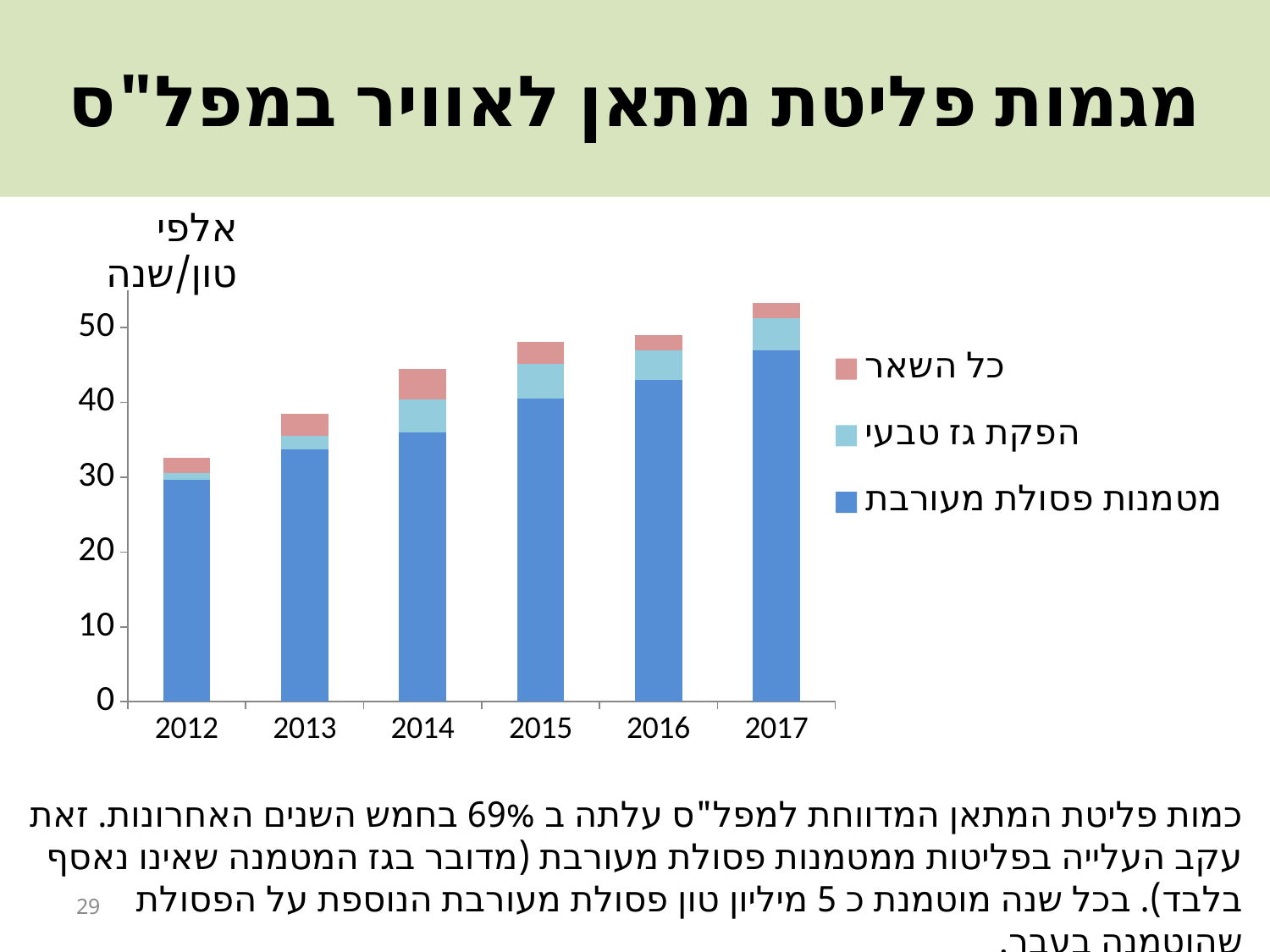
Is the value of the מטמנות פסולת מעורבת segment for 2017 greater or less than 40? greater What unit is written above the y axis of the chart? אלפי טון/שנה How many series does the chart's legend list? 3 Which year has the shortest stacked bar (lowest total methane emissions)? 2012 Do the total bar heights rise or fall from 2012 to 2017? Rise What kind of chart is shown on the slide? Stacked bar chart Is the total bar height for 2013 greater or less than 40? less Which legend entry is represented by the dark blue (bottom) segments of the bars? מטמנות פסולת מעורבת Is the total bar height for 2014 larger or smaller than the total for 2013? Larger Is the total bar height for 2017 greater or less than 50? greater How many years are shown on the x axis of the chart? 6 Which year has the tallest stacked bar (highest total methane emissions)? 2017